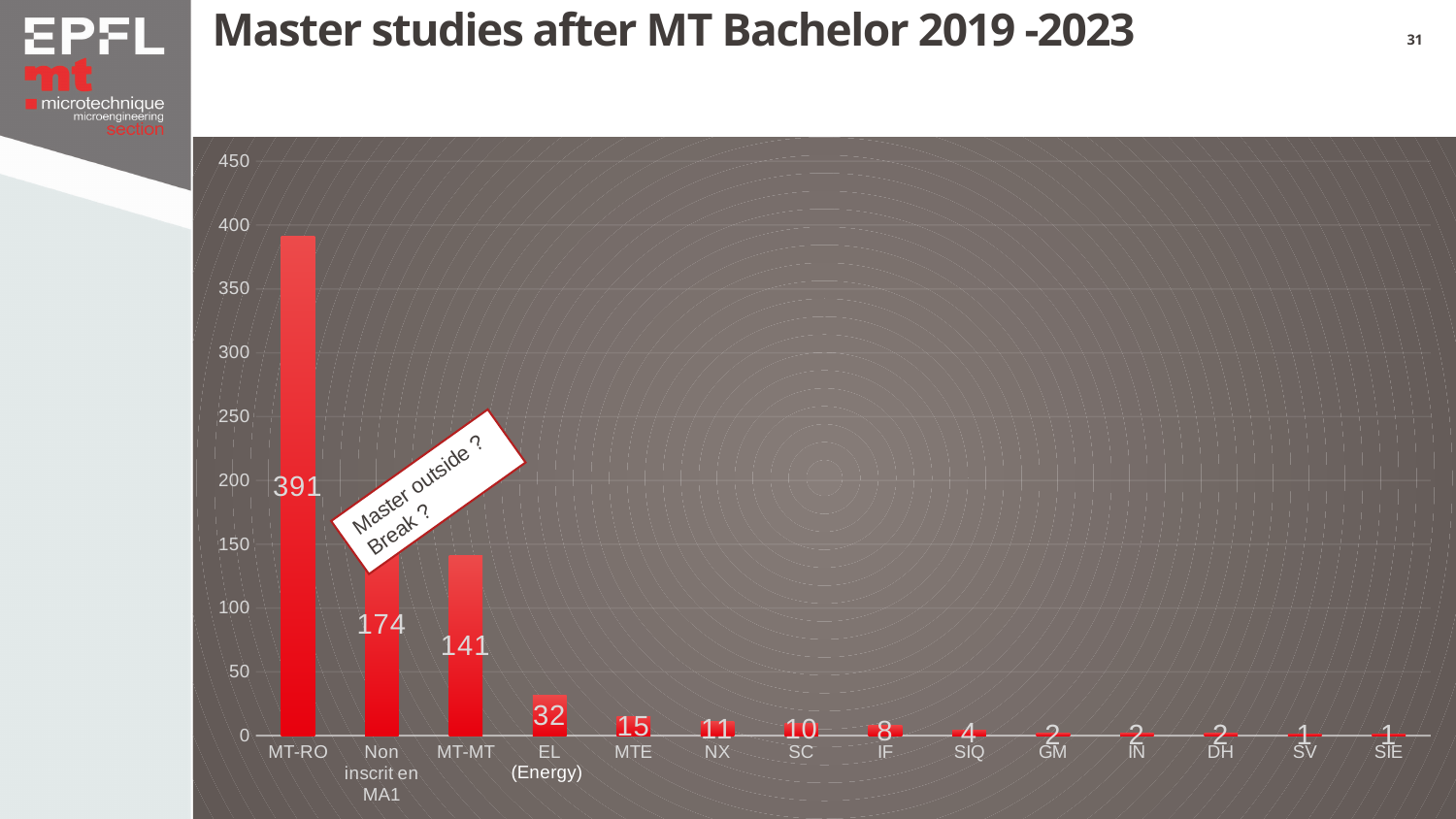
Which is larger, the value for MTE or the value for NX? MTE What is the value for Non inscrit en MA1? 174 What kind of chart is shown on the slide? bar chart How many categories are shown on the x axis? 14 What is the title of the chart? Master studies after MT Bachelor 2019 -2023 What is the value for MT-MT? 141 What is the difference between the values for MT-RO and MT-MT? 250 What is the difference between the values for Non inscrit en MA1 and EL (Energy)? 142 What is the value for MT-RO? 391 Is the value for MT-RO greater or less than 350? greater What is the value for EL (Energy)? 32 Which category has the highest value? MT-RO